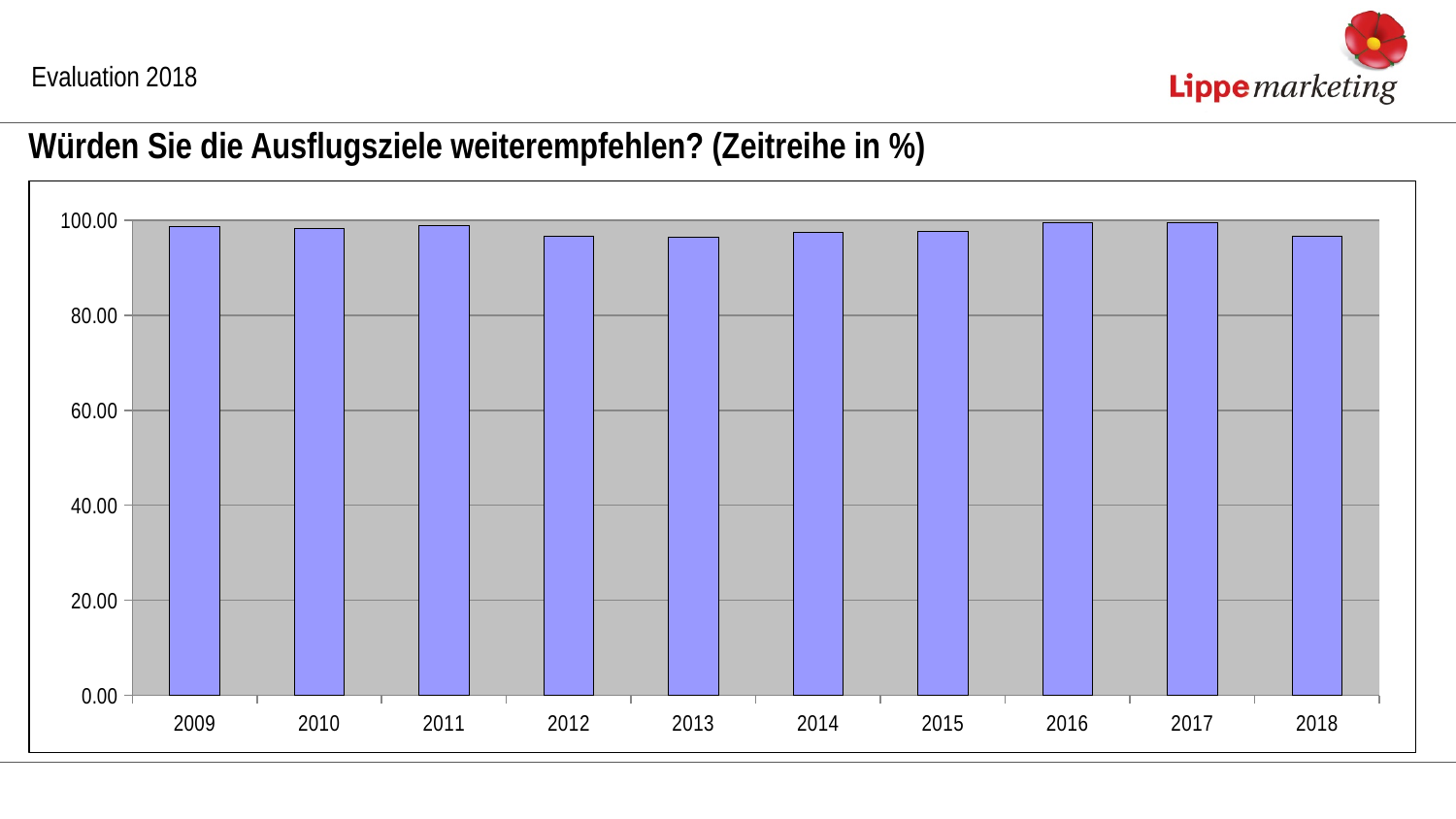
Is the value for 2018 greater or less than 60? greater How many years are shown on the x axis of the chart? 10 Is the value for 2016 greater or less than 40? greater Is the value for 2012 greater or less than 20? greater What is the highest tick value shown on the y axis? 100.00 What is the first year shown on the x axis? 2009 What kind of chart is shown on the slide? bar chart